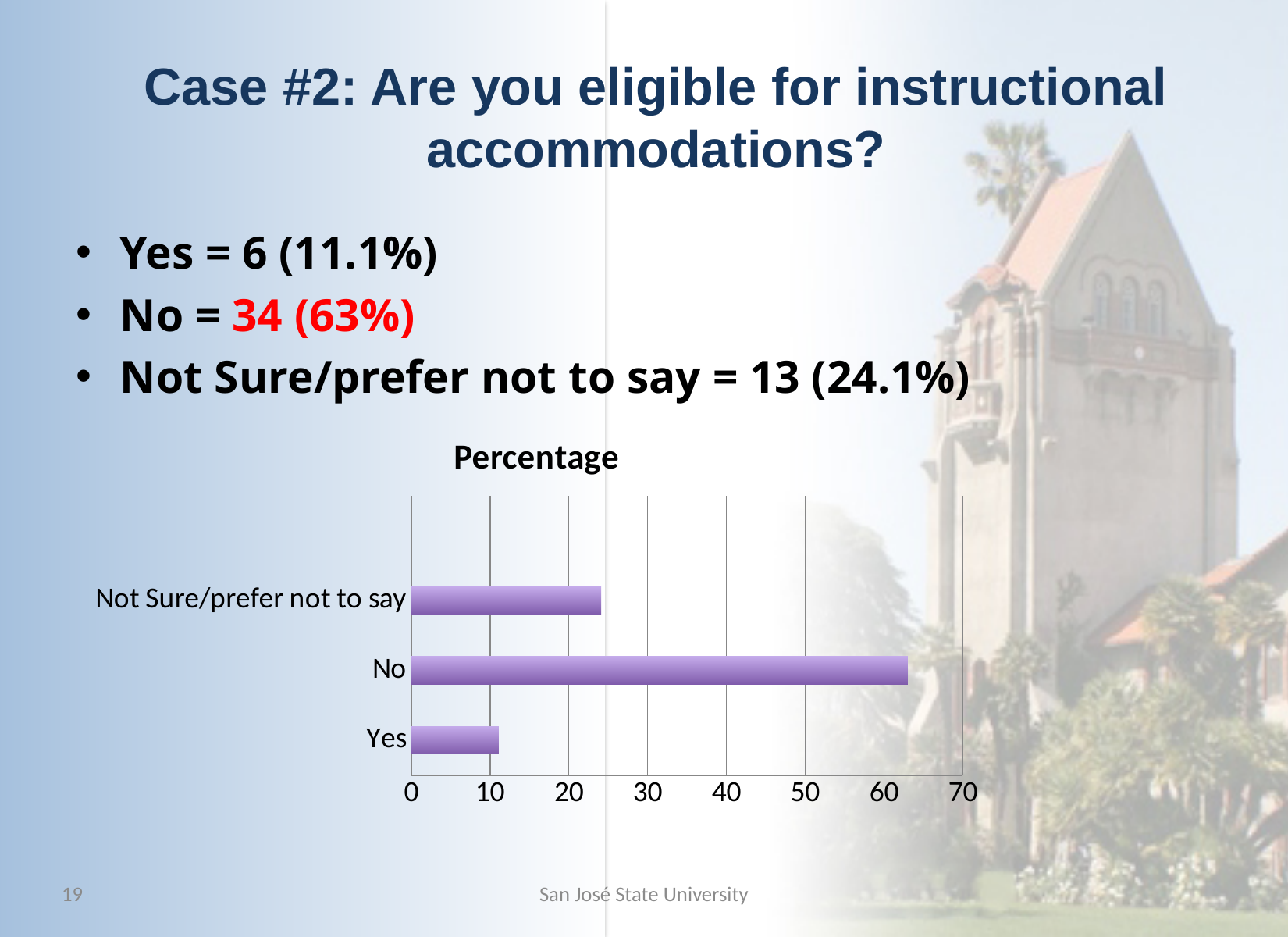
Which category has the highest value in the chart? No How many categories are plotted in the chart? 3 What is the maximum value shown on the chart's horizontal axis? 70 Which category has the lowest value in the chart? Yes What is the title of the chart? Percentage Is the value for Yes greater or less than 20? less According to the slide, what percentage of respondents answered No? 63% Is the value for No greater or less than 60? greater Is the value for Not Sure/prefer not to say greater or less than 20? greater What type of chart is shown on the slide? bar chart According to the slide, what percentage of respondents answered Yes? 11.1% Which is larger, the value for Not Sure/prefer not to say or the value for Yes? Not Sure/prefer not to say